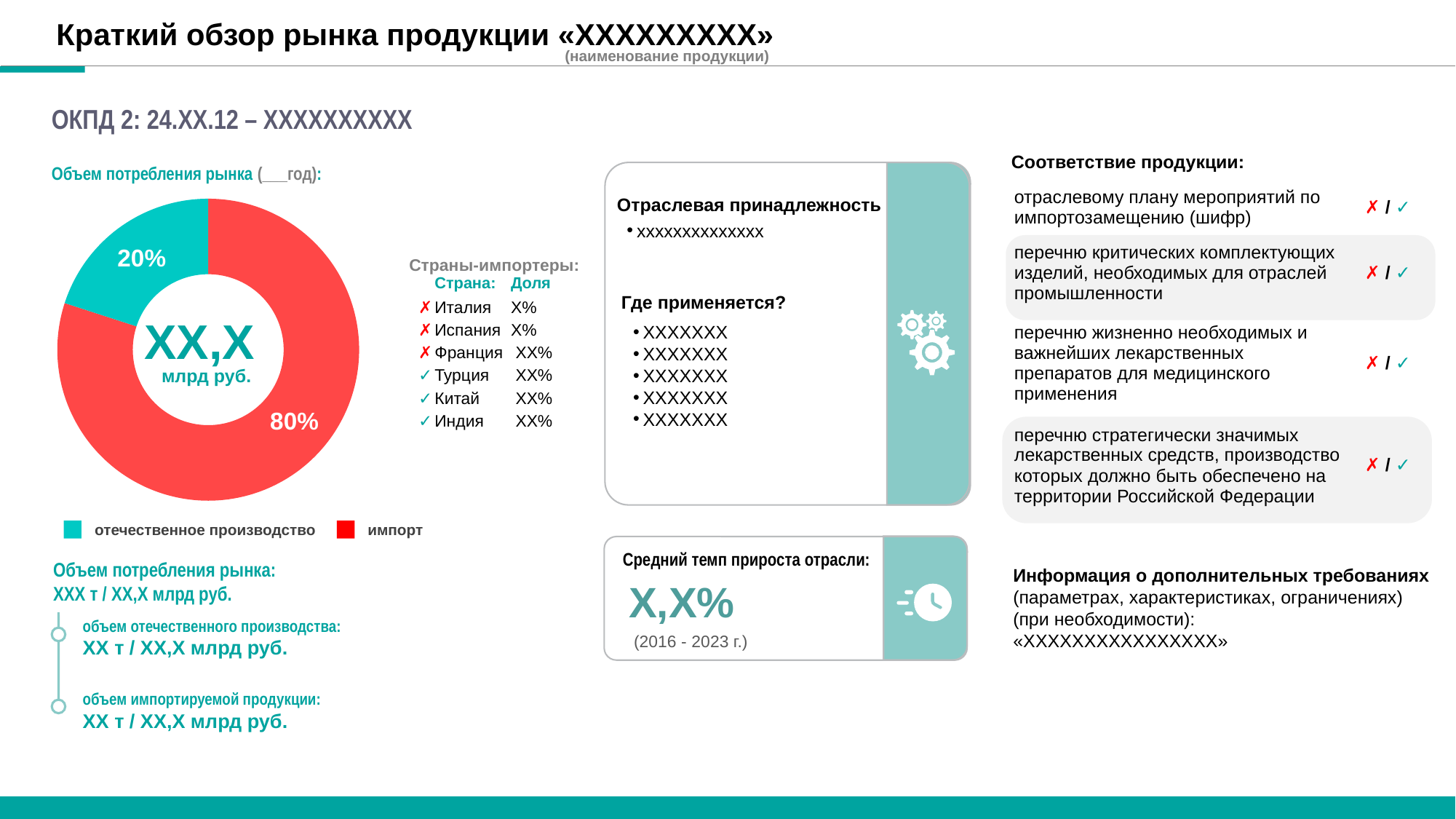
What share of the pie does the "отечественное производство" slice represent? 20% Which category has the largest slice in the pie chart? импорт What kind of chart is shown on the slide? doughnut chart Which is larger in the pie chart: "импорт" or "отечественное производство"? импорт What colour is the "импорт" slice in the pie chart? red What is the difference in percentage points between the "импорт" slice and the "отечественное производство" slice? 60 What share of the pie chart is labelled "отечественное производство"? 20% Which category has the smallest slice in the pie chart? отечественное производство What is the title of the pie chart? Объем потребления рынка (___год): How many entries does the legend of the pie chart list? 2 How many slices does the pie chart have? 2 What share of the pie chart is labelled "импорт"? 80%